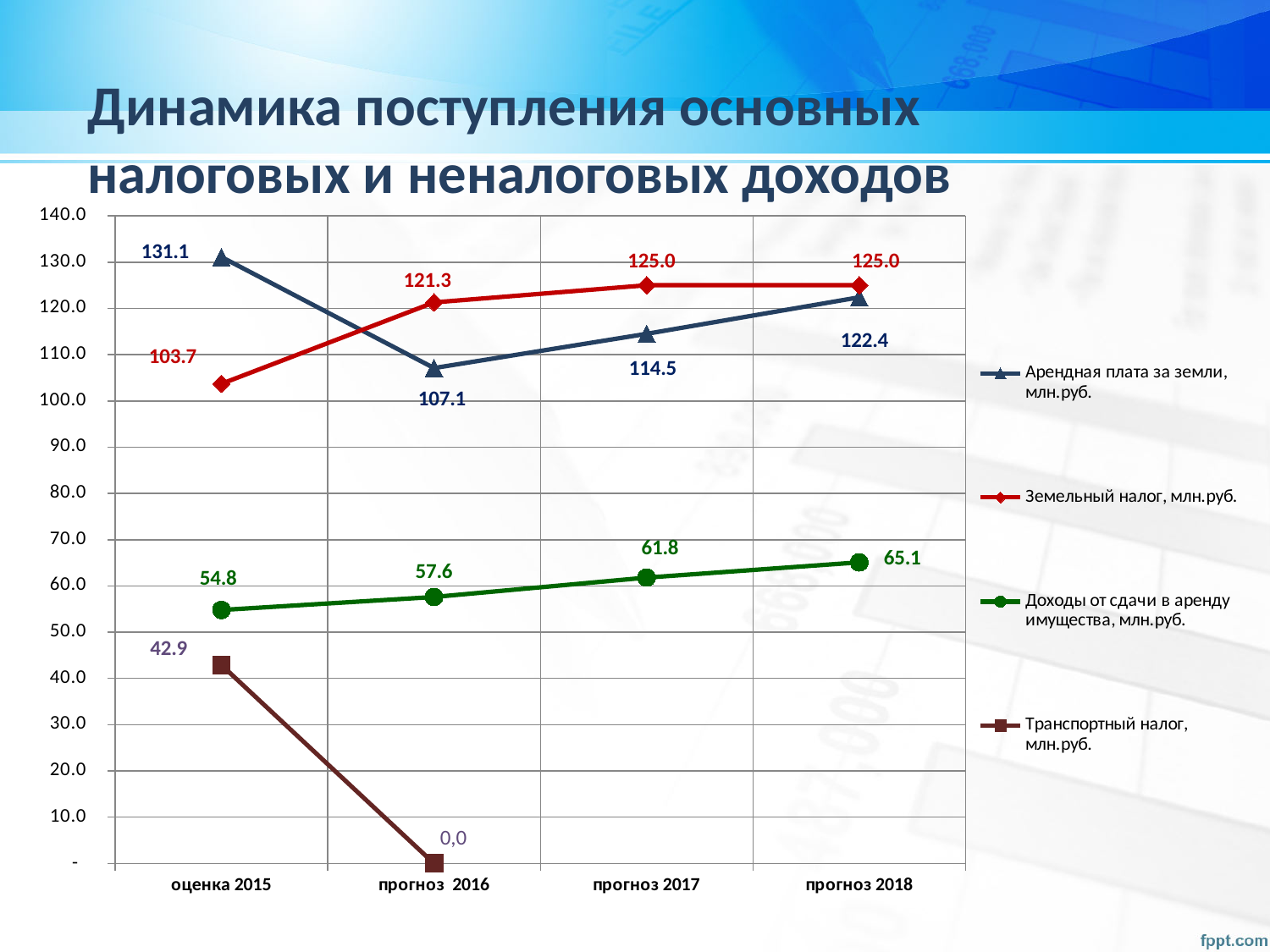
How many series does the legend list? 4 What is the value of Транспортный налог for оценка 2015? 42.9 What is the value of Земельный налог for прогноз 2016? 121.3 In which category is Арендная плата за земли lowest? прогноз 2016 Do the values of Доходы от сдачи в аренду имущества rise or fall from оценка 2015 to прогноз 2018? rise What is the value of Арендная плата за земли for оценка 2015? 131.1 What is the difference between Земельный налог and Арендная плата за земли for прогноз 2017? 10.5 What is the value of Доходы от сдачи в аренду имущества for прогноз 2018? 65.1 What type of chart is shown on the slide? line chart In which category is Земельный налог lowest? оценка 2015 Which is larger for оценка 2015: Арендная плата за земли or Земельный налог? Арендная плата за земли How many categories are shown on the x axis? 4